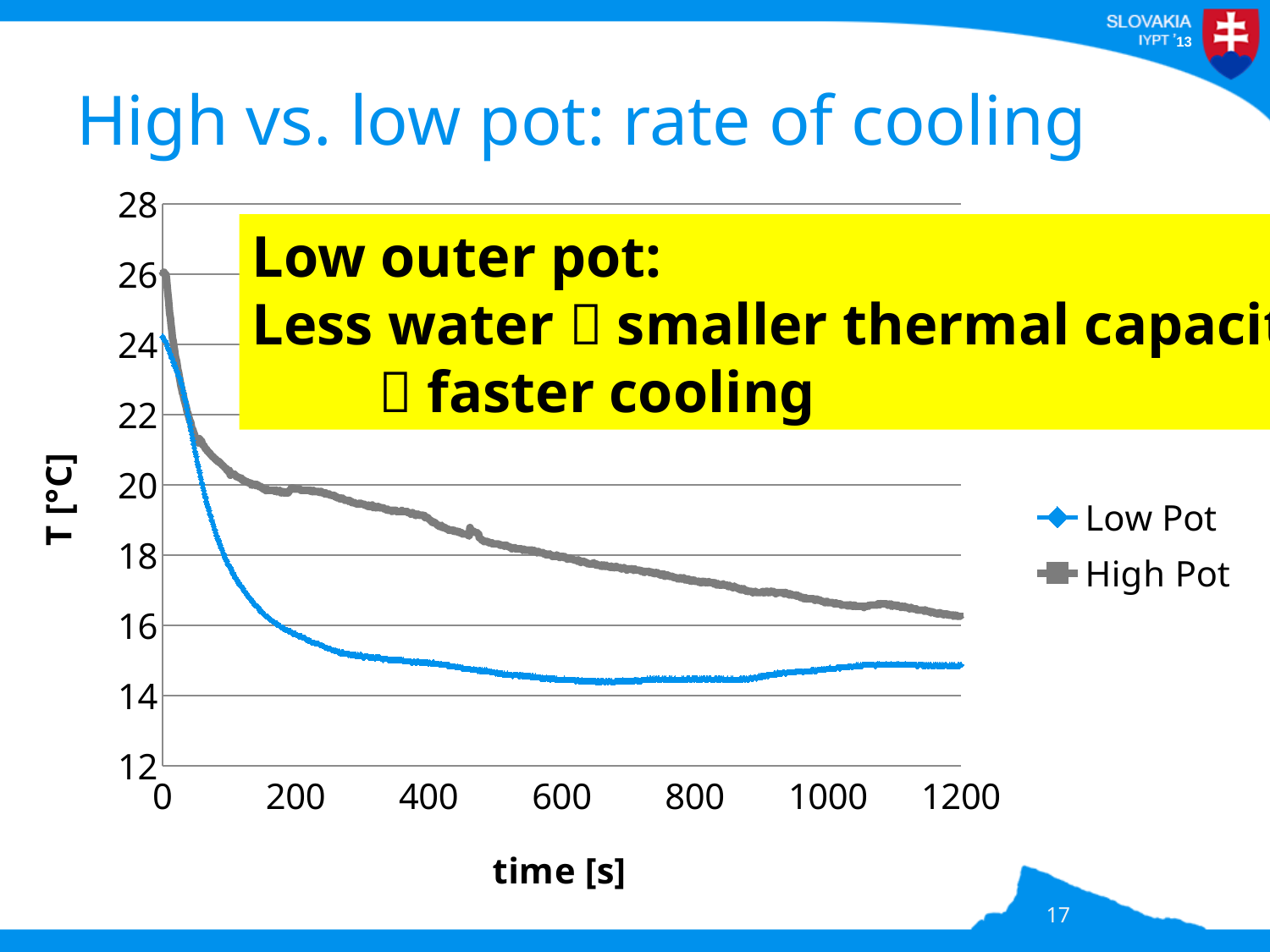
Is the value for High Pot at 400 s greater or less than 18? greater How many series does the legend list? 2 Does the temperature of the High Pot series rise or fall as time increases? fall Which series cools faster over the first 200 s, Low Pot or High Pot? Low Pot Which series has the higher temperature at 1200 s, Low Pot or High Pot? High Pot Is the value for Low Pot at 400 s greater or less than 16? less Which series does the legend list first? Low Pot What kind of chart is shown on the slide? line chart Is the value for Low Pot at 600 s greater or less than 16? less What is the label of the y axis? T [°C]